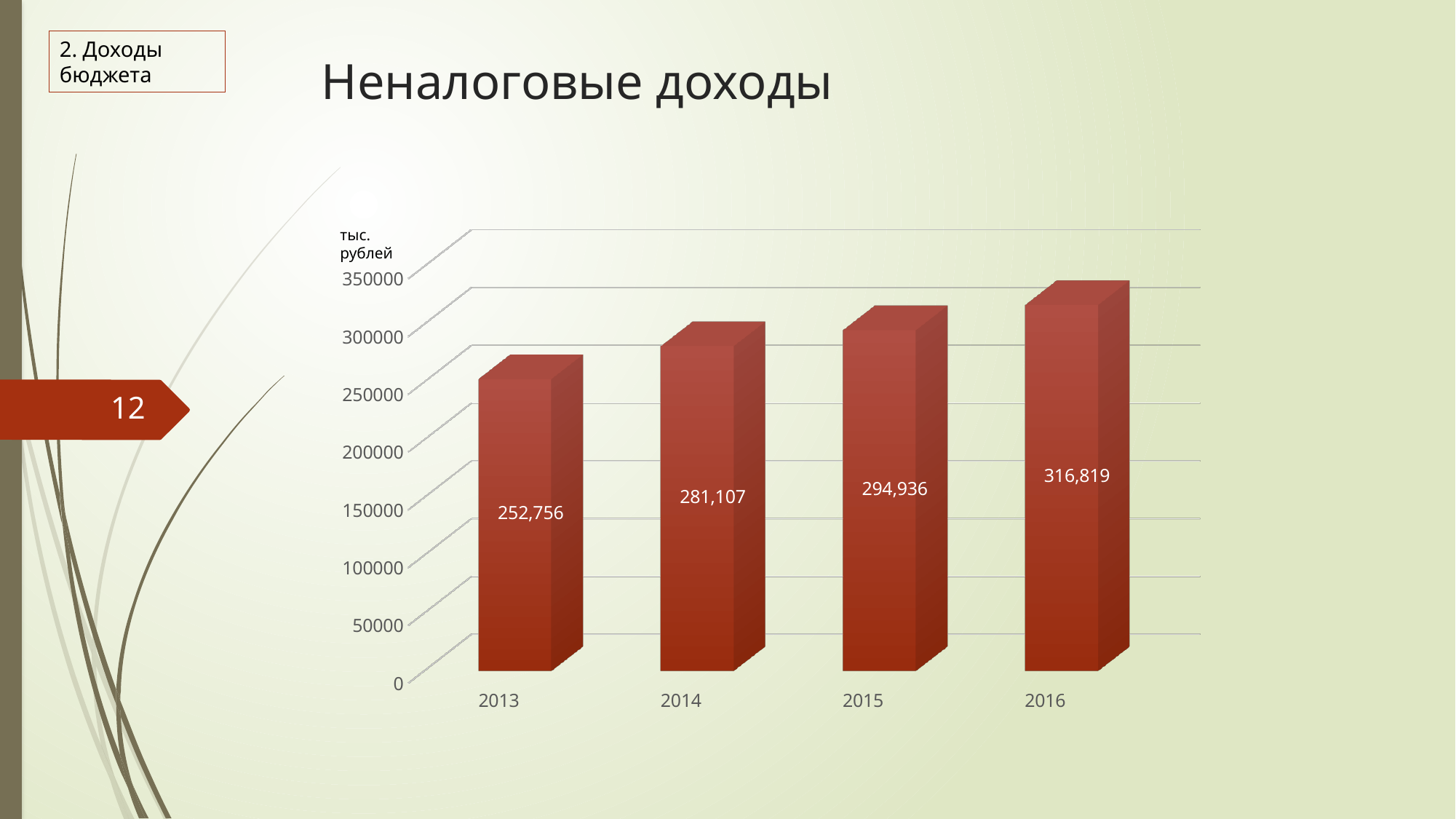
What kind of chart is shown on the slide? bar chart What is the value for 2013? 252,756 Which is larger, the value for 2014 or the value for 2015? 2015 What is the value for 2016? 316,819 How many years are shown on the x axis? 4 Which year has the highest value? 2016 What is the value for 2015? 294,936 Is the value for 2014 greater or less than 300000? less Do the values rise or fall from 2013 to 2016? rise Which year has the lowest value? 2013 What is the difference between the values for 2016 and 2015? 21,883 What is the difference between the values for 2014 and 2013? 28,351